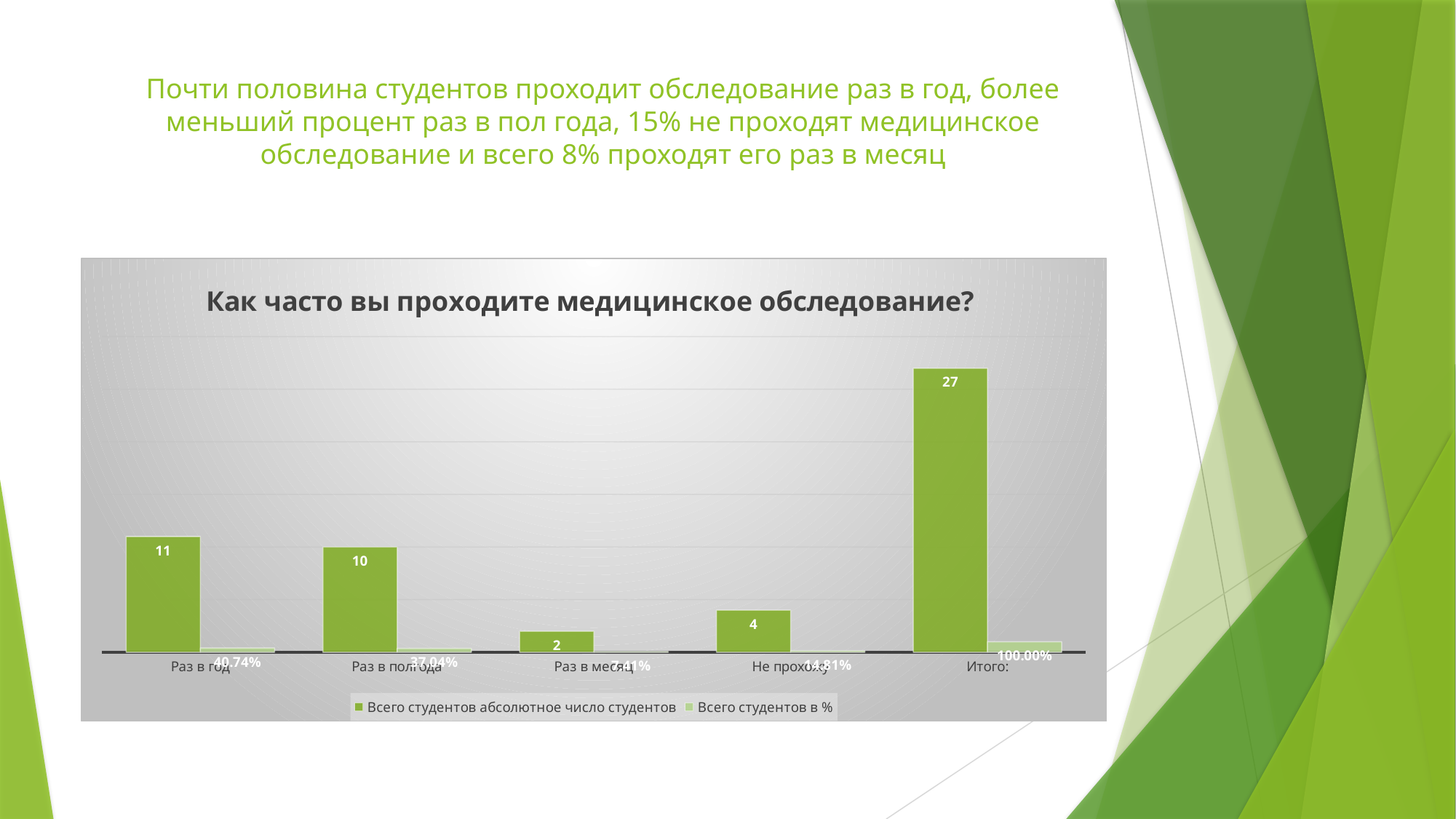
How many series does the legend list? 2 What is the absolute number of students for "Не прохожу"? 4 Excluding "Итого:", which category has the lowest absolute number of students? Раз в месяц What percentage of students is shown for "Раз в год"? 40.74% What is the absolute number of students for "Раз в год"? 11 What is the title of the chart? Как часто вы проходите медицинское обследование? What percentage of students is shown for "Не прохожу"? 14.81% What is the absolute number of students for "Итого:"? 27 What is the absolute number of students for "Раз в полгода"? 10 Which has more students in absolute number, "Раз в полгода" or "Не прохожу"? Раз в полгода What is the difference in absolute number of students between "Раз в год" and "Не прохожу"? 7 Which category has the highest absolute number of students? Итого: